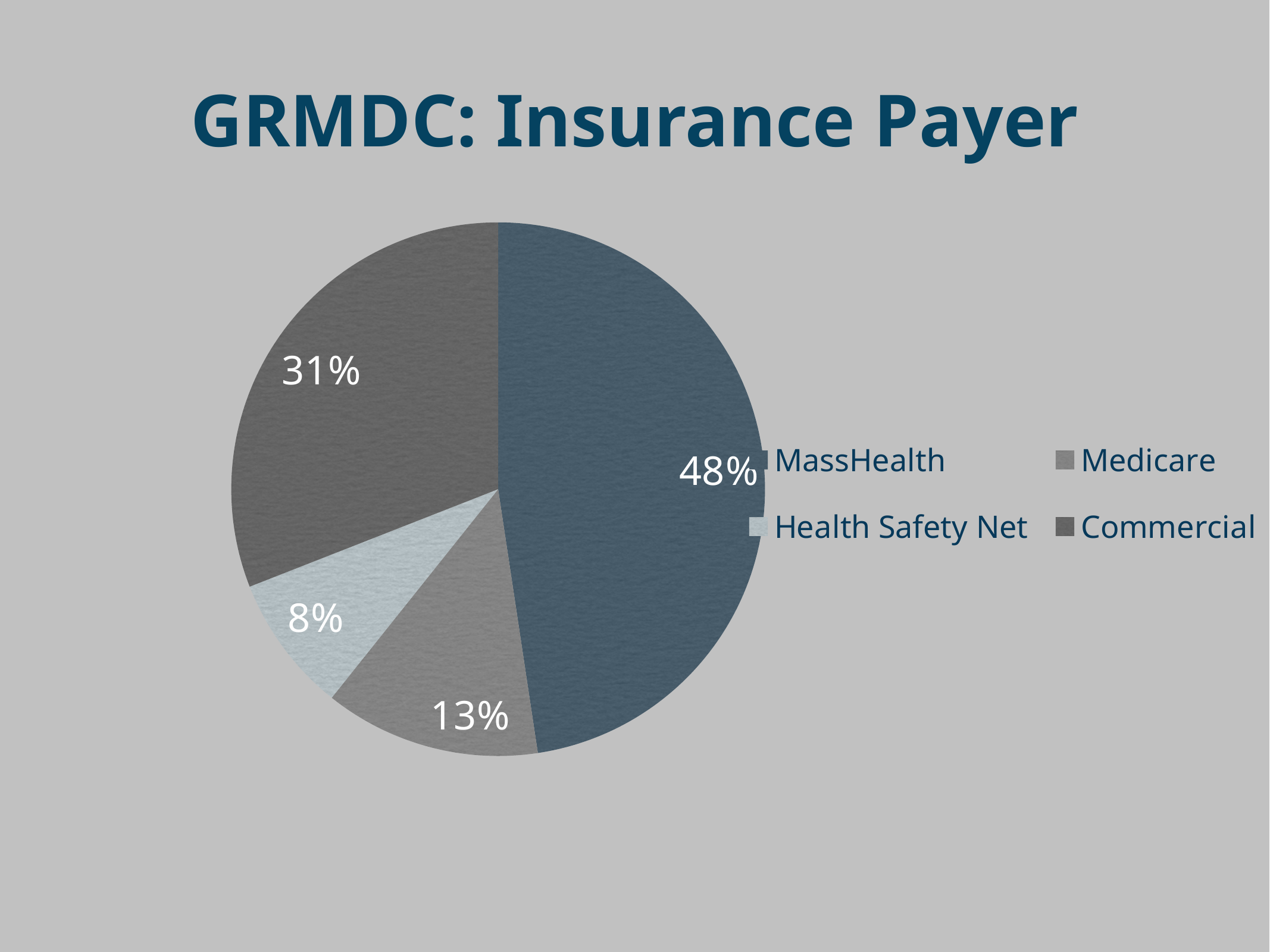
What is the title of the chart? GRMDC: Insurance Payer What share of the pie does Commercial represent? 31% What share of the pie does Health Safety Net represent? 8% What share of the pie does Medicare represent? 13% How many insurance payer categories are shown in the pie chart? 4 How many entries does the legend list? 4 What is the difference in percentage points between MassHealth and Commercial? 17 Which insurance payer has the smallest slice of the pie? Health Safety Net Which insurance payer has the largest slice of the pie? MassHealth Which is larger, the Medicare slice or the Health Safety Net slice? Medicare What kind of chart is shown on the slide? Pie chart